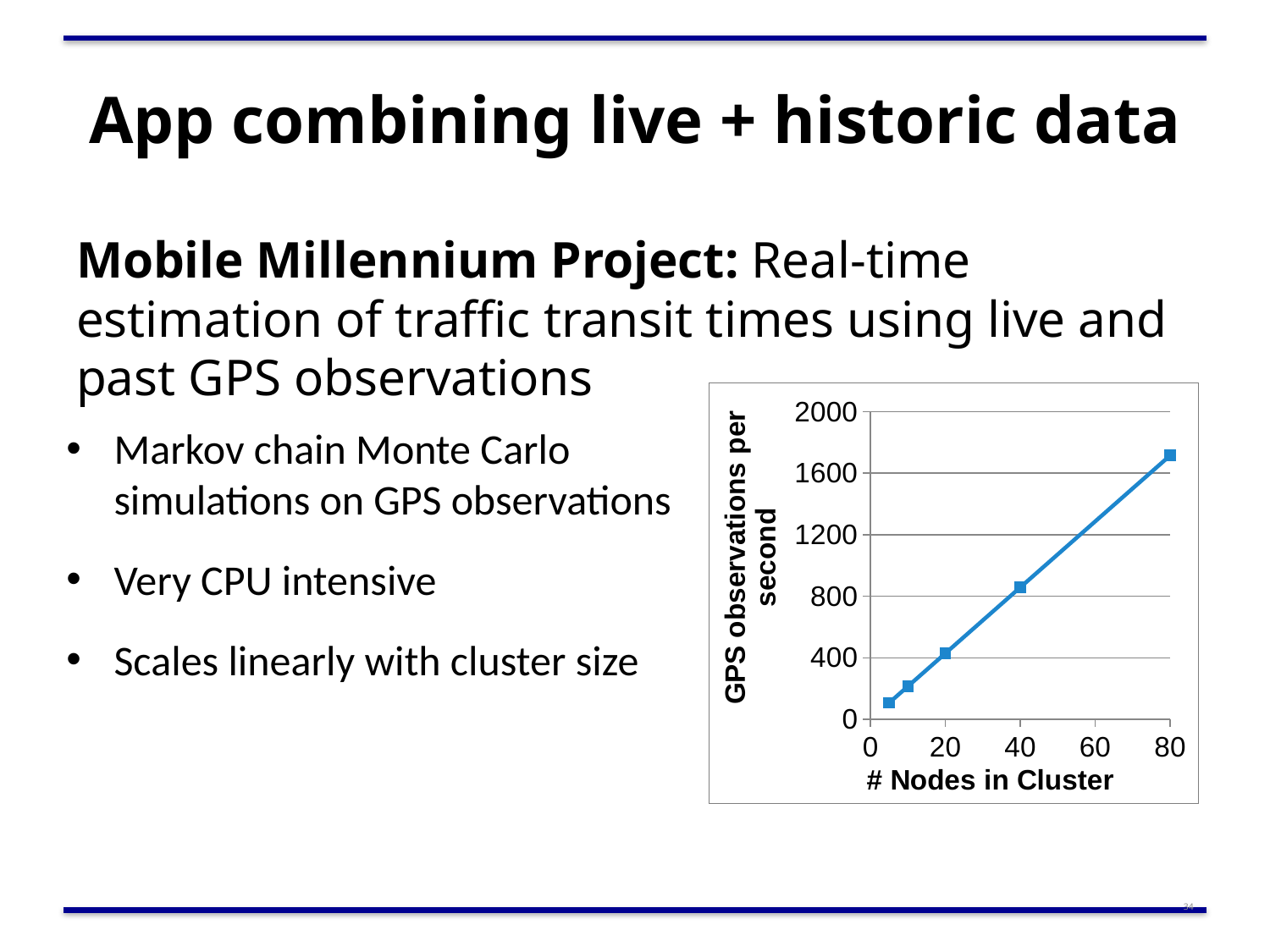
At which number of nodes in the cluster is the GPS observations per second value highest? 80 What is the title of the y axis of the chart? GPS observations per second Is the value for 20 nodes in the cluster greater or less than 800 GPS observations per second? less What is the maximum value shown on the y axis of the chart? 2000 Is the value for 40 nodes in the cluster greater or less than 1200 GPS observations per second? less Which has more GPS observations per second: 40 nodes or 80 nodes in the cluster? 80 nodes How many data points are plotted on the chart? 5 Is the value for 80 nodes in the cluster greater or less than 1600 GPS observations per second? greater What is the title of the x axis of the chart? # Nodes in Cluster What kind of chart is shown on the slide? line chart Do GPS observations per second rise or fall as the number of nodes in the cluster increases? rise